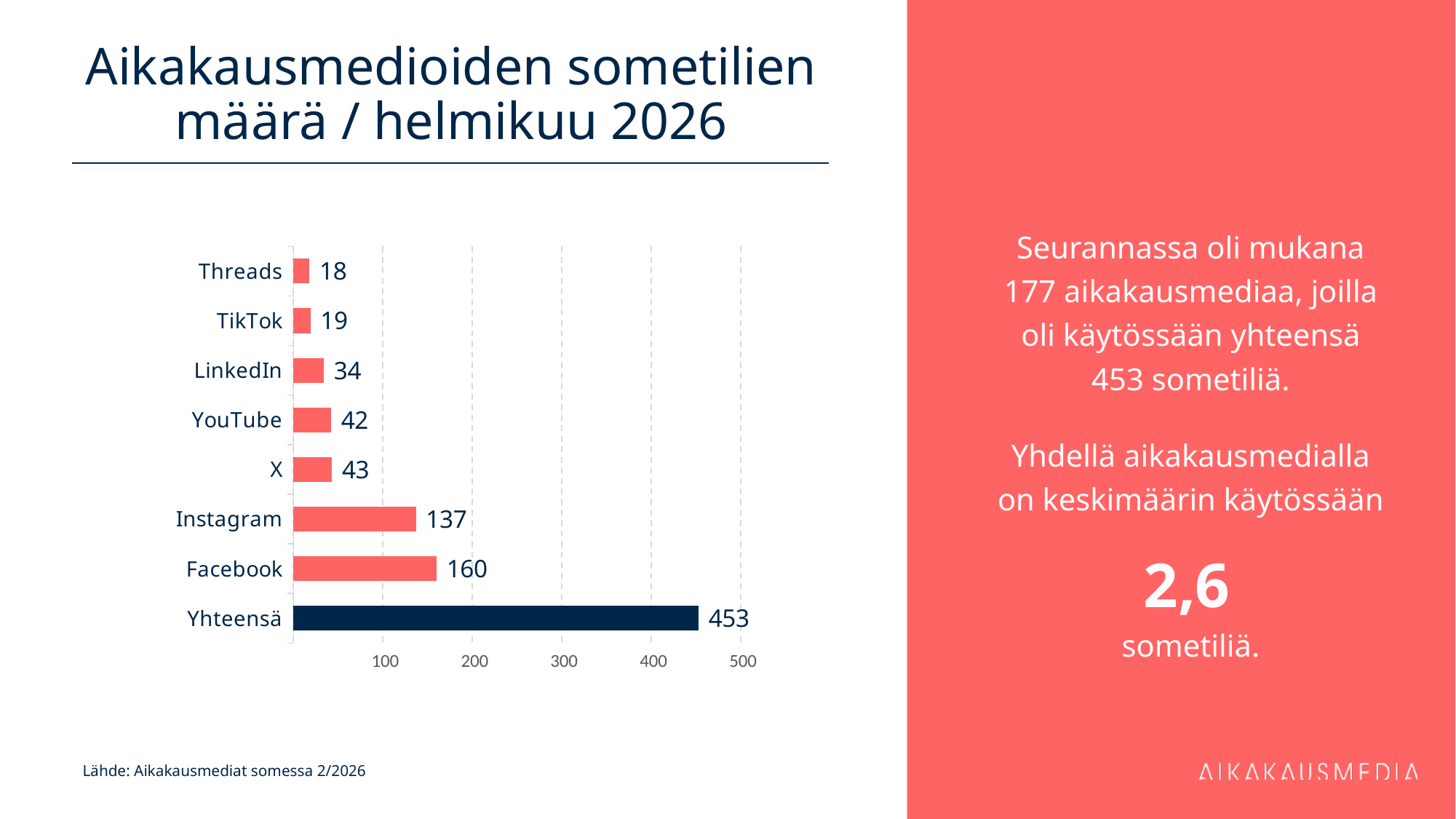
How many categories are shown on the chart? 8 Is the value for Instagram greater or less than 100? greater Which category has the lowest value? Threads What kind of chart is shown on the slide? Bar chart What is the title of the chart on the slide? Aikakausmedioiden sometilien määrä / helmikuu 2026 What is the value for Instagram? 137 Which is larger, the value for YouTube or the value for LinkedIn? YouTube What is the difference between the values for Facebook and Instagram? 23 What is the value for Facebook? 160 What is the value shown for Yhteensä? 453 Which individual platform (excluding Yhteensä) has the highest value? Facebook What is the value for LinkedIn? 34